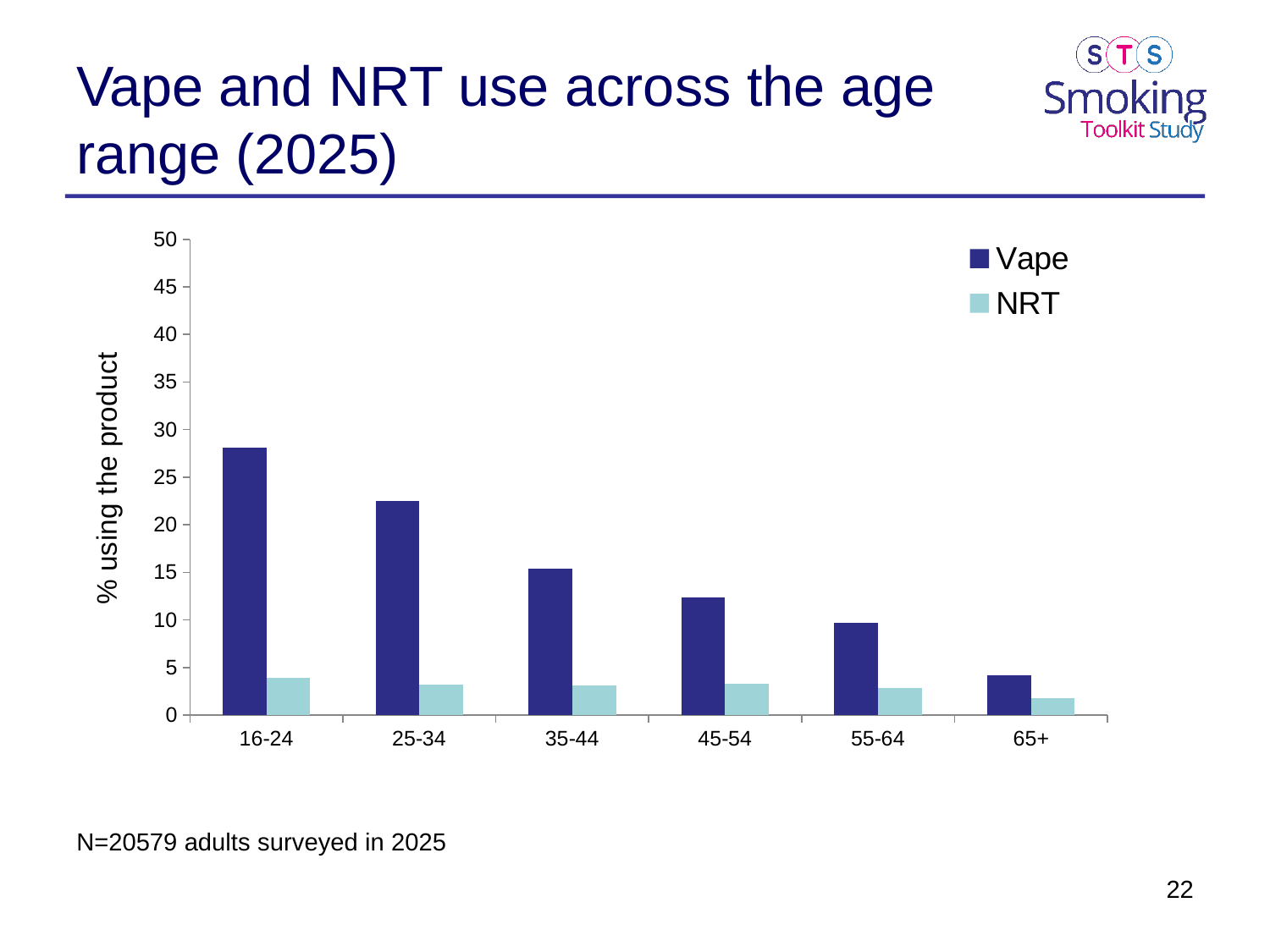
Which age group has the highest Vape value? 16-24 How many age groups are shown on the x axis? 6 Is the Vape value for 16-24 greater or less than 25? greater Is the Vape value for 65+ greater or less than 5? less Which age group has the lowest Vape value? 65+ In the 16-24 age group, which is larger, Vape or NRT? Vape What kind of chart is shown on the slide? bar chart Is the Vape value for 25-34 greater or less than 20? greater Which age group has the lowest NRT value? 65+ Do the Vape values rise or fall as age increases along the x axis? fall How many series does the legend list? 2